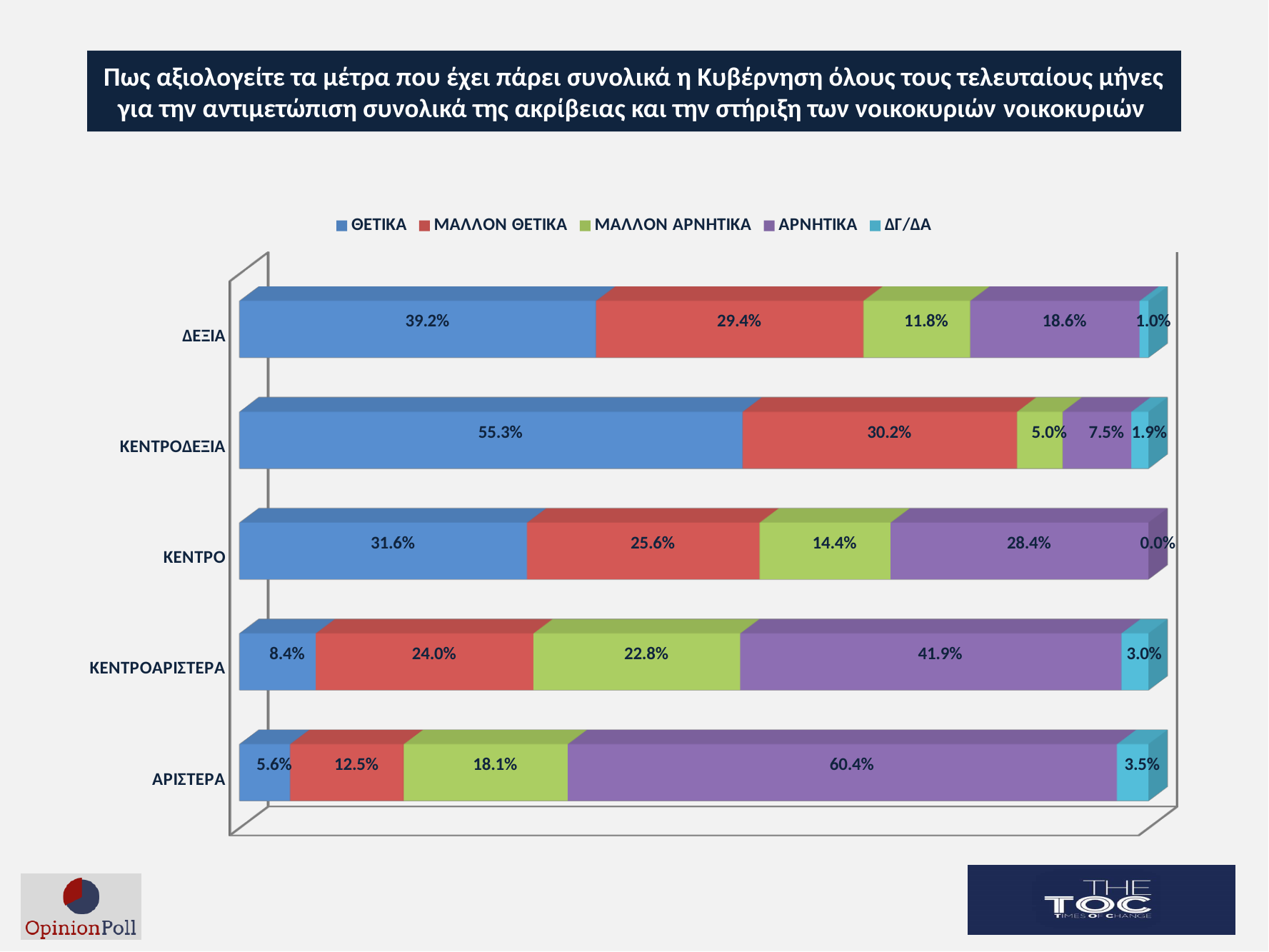
How many series does the legend list? 5 What is the ΔΓ/ΔΑ value for ΚΕΝΤΡΟ? 0.0% Which colour represents the ΑΡΝΗΤΙΚΑ series in the legend? Purple What is the ΘΕΤΙΚΑ value for ΚΕΝΤΡΟΔΕΞΙΑ? 55.3% What is the ΜΑΛΛΟΝ ΑΡΝΗΤΙΚΑ value for ΚΕΝΤΡΟ? 14.4% What type of chart is shown on the slide? Stacked bar chart How many categories are shown on the vertical axis? 5 Which is larger: the ΜΑΛΛΟΝ ΘΕΤΙΚΑ value for ΔΕΞΙΑ or for ΚΕΝΤΡΟΑΡΙΣΤΕΡΑ? ΔΕΞΙΑ What is the difference between the ΘΕΤΙΚΑ values for ΚΕΝΤΡΟΔΕΞΙΑ and ΔΕΞΙΑ? 16.1% Which category has the highest ΘΕΤΙΚΑ value? ΚΕΝΤΡΟΔΕΞΙΑ What is the ΑΡΝΗΤΙΚΑ value for ΑΡΙΣΤΕΡΑ? 60.4% Which category has the lowest ΑΡΝΗΤΙΚΑ value? ΚΕΝΤΡΟΔΕΞΙΑ